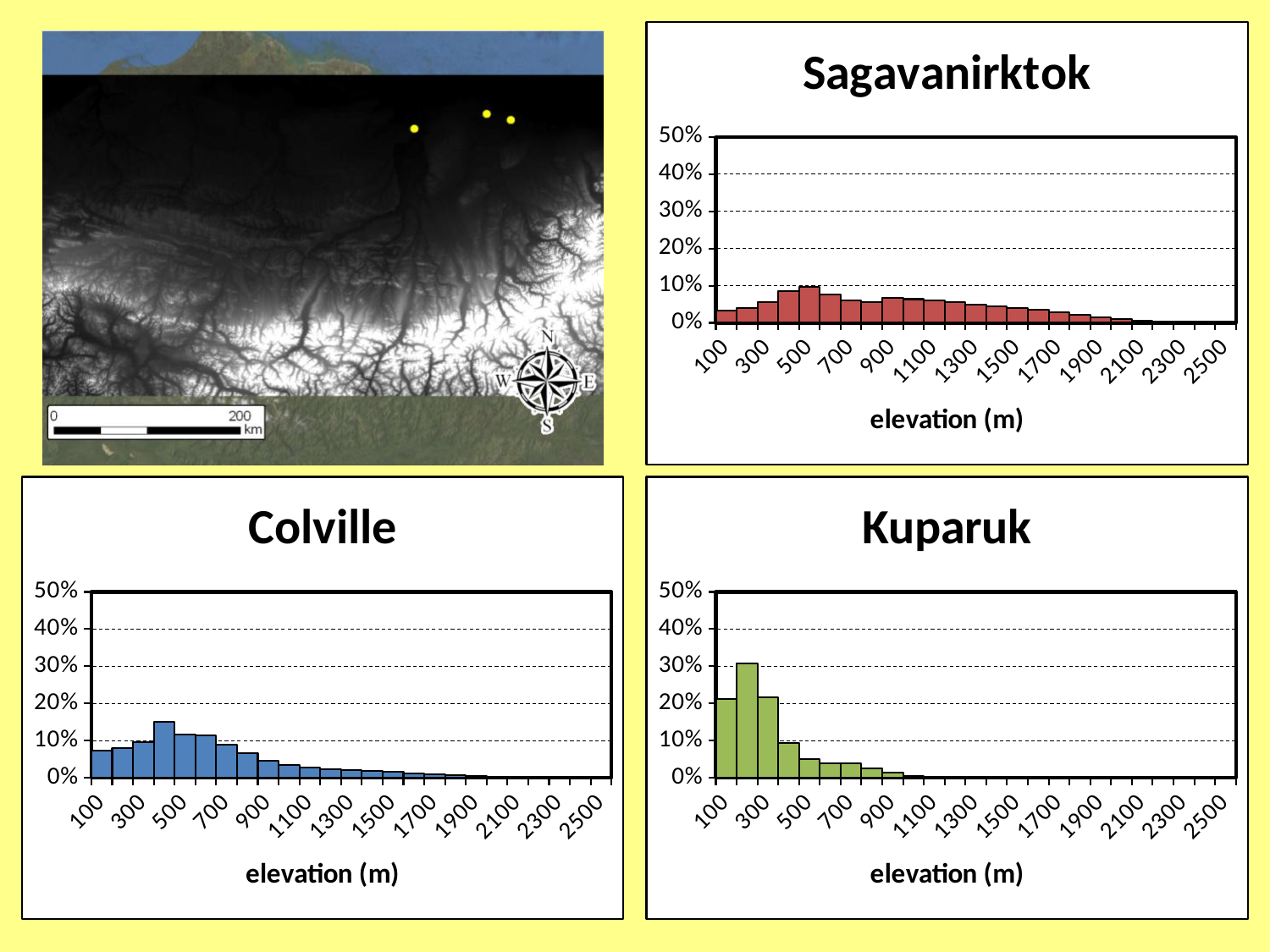
In the Colville chart, is the value for the 100 m bin greater or less than 10%? less Which is larger: the tallest bar in the Kuparuk chart or the tallest bar in the Colville chart? Kuparuk What is the x-axis label on the Sagavanirktok chart? elevation (m) In the Kuparuk chart, which elevation bin has the highest bar? 200 In the Colville chart, which elevation bin has the highest bar? 400 What colour are the bars in the Colville chart? blue In the Kuparuk chart, is the value for the 300 m bin greater or less than 20%? greater In the Kuparuk chart, is the value for the 700 m bin greater or less than 10%? less What kind of chart is the Kuparuk chart? bar chart In the Kuparuk chart, do the values rise or fall as elevation increases beyond 300 m? fall